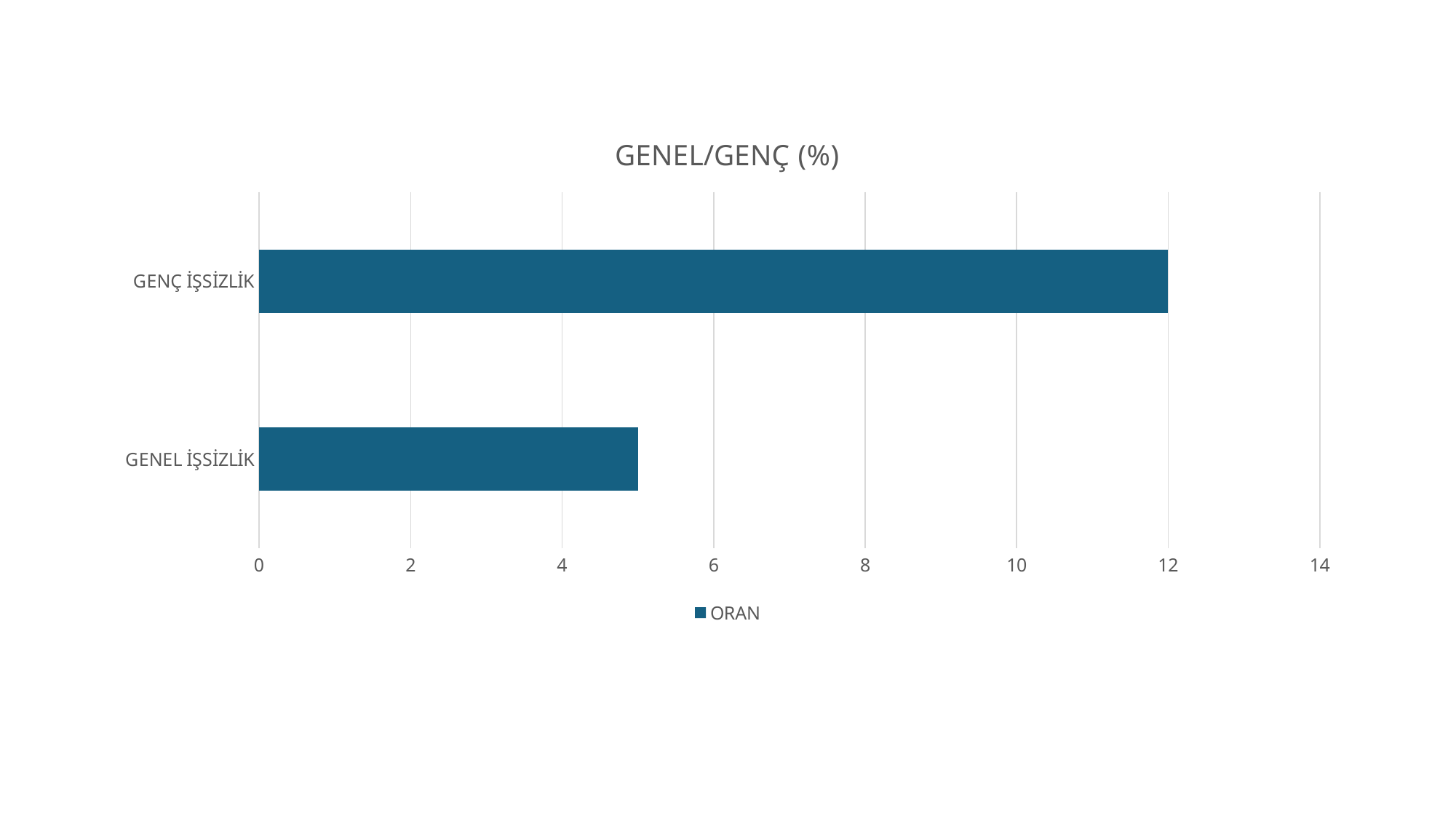
Which category has the highest value? GENÇ İŞSİZLİK What is the title of the chart? GENEL/GENÇ (%) Which category has the lowest value? GENEL İŞSİZLİK Is the value for GENÇ İŞSİZLİK greater or less than 10? greater Is the value for GENEL İŞSİZLİK greater or less than 4? greater How many series does the legend list? 1 How many categories are shown in the chart? 2 What is the name of the series in the legend? ORAN What kind of chart is shown on the slide? bar chart What is the value for GENÇ İŞSİZLİK? 12 Which is larger, the value for GENÇ İŞSİZLİK or the value for GENEL İŞSİZLİK? GENÇ İŞSİZLİK Is the value for GENEL İŞSİZLİK greater or less than 6? less